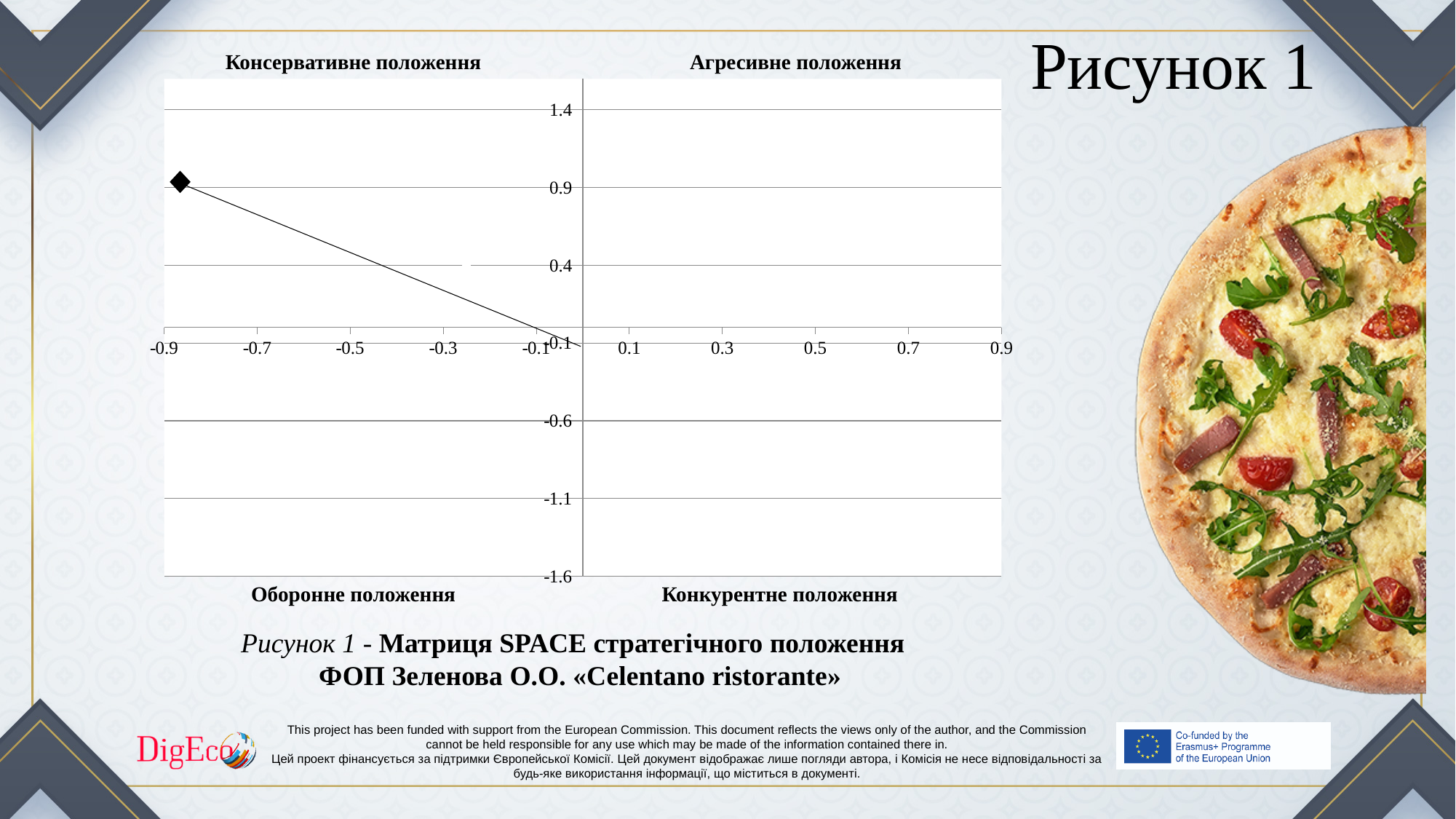
What is the lowest tick value shown on the y axis? -1.6 How many data points are plotted on the chart? 1 Is the x-coordinate of the plotted point greater or less than 0? less What is the label of the bottom-right quadrant of the chart? Конкурентне положення What is the highest tick value shown on the x axis? 0.9 What is the highest tick value shown on the y axis? 1.4 Is the x-coordinate of the plotted point greater or less than -0.5? less What kind of chart is shown on the slide? scatter chart Is the y-coordinate of the plotted point greater or less than 1.4? less In which labelled quadrant does the plotted point lie? Консервативне положення